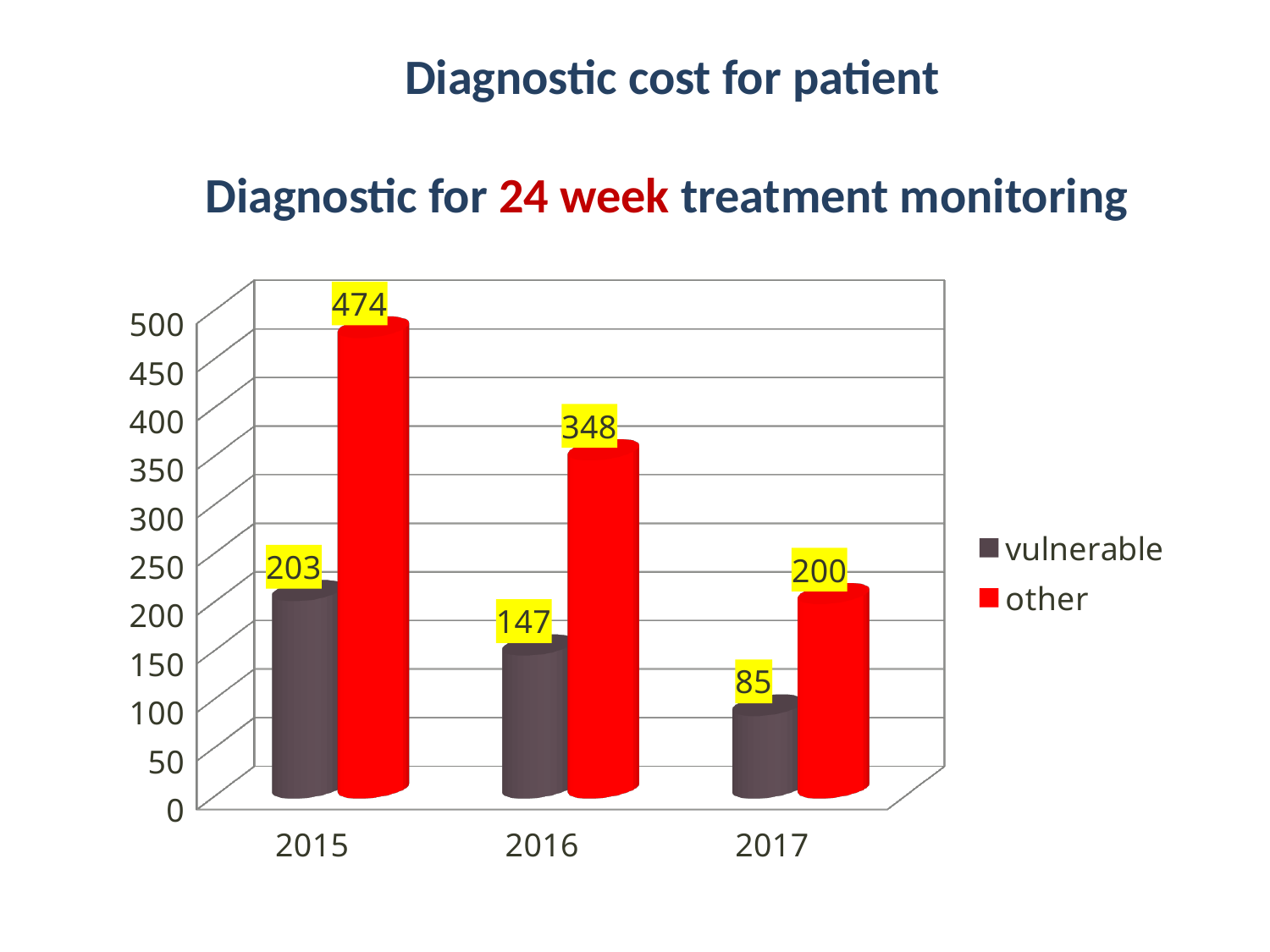
Which year has the lowest value for 'vulnerable'? 2017 How many series does the legend list? 2 What is the value for 'other' in 2015? 474 What kind of chart is shown? bar chart What is the difference between the 'other' values for 2016 and 2017? 148 Do the 'vulnerable' values rise or fall from 2015 to 2017? fall Which is larger in 2016, 'vulnerable' or 'other'? other How many years are shown on the x axis? 3 What is the value for 'vulnerable' in 2017? 85 What is the difference between 'other' and 'vulnerable' in 2015? 271 Which year has the highest value for 'other'? 2015 What is the value for 'vulnerable' in 2016? 147